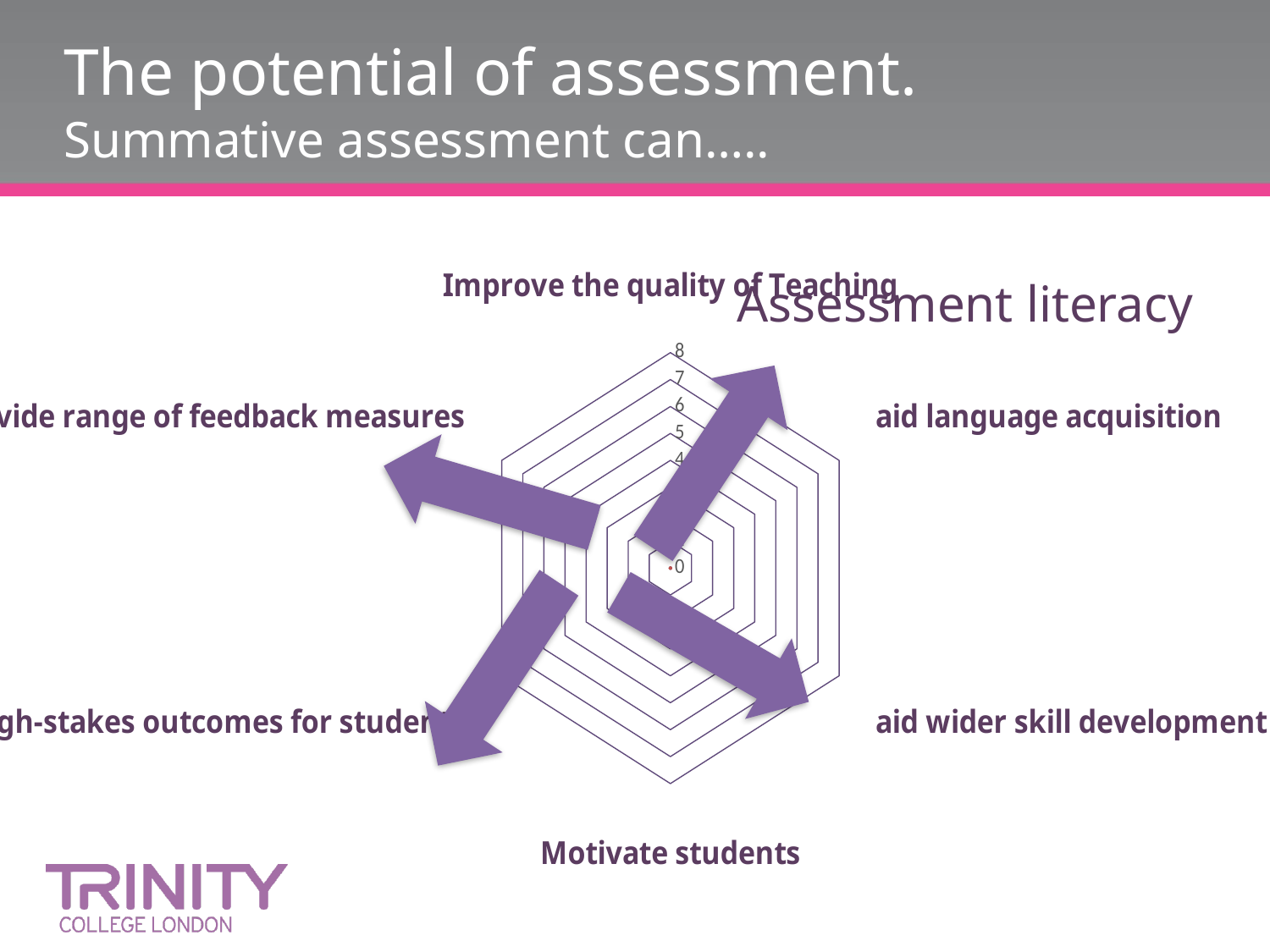
Which category label appears at the top of the radar chart? Improve the quality of Teaching How many axes (categories) does the radar chart have? 6 What is the highest value shown on the radar chart's axis scale? 8 Which category label appears at the bottom of the radar chart? Motivate students What value is printed at the centre of the radar chart? 0 What kind of chart is shown on the slide? radar chart